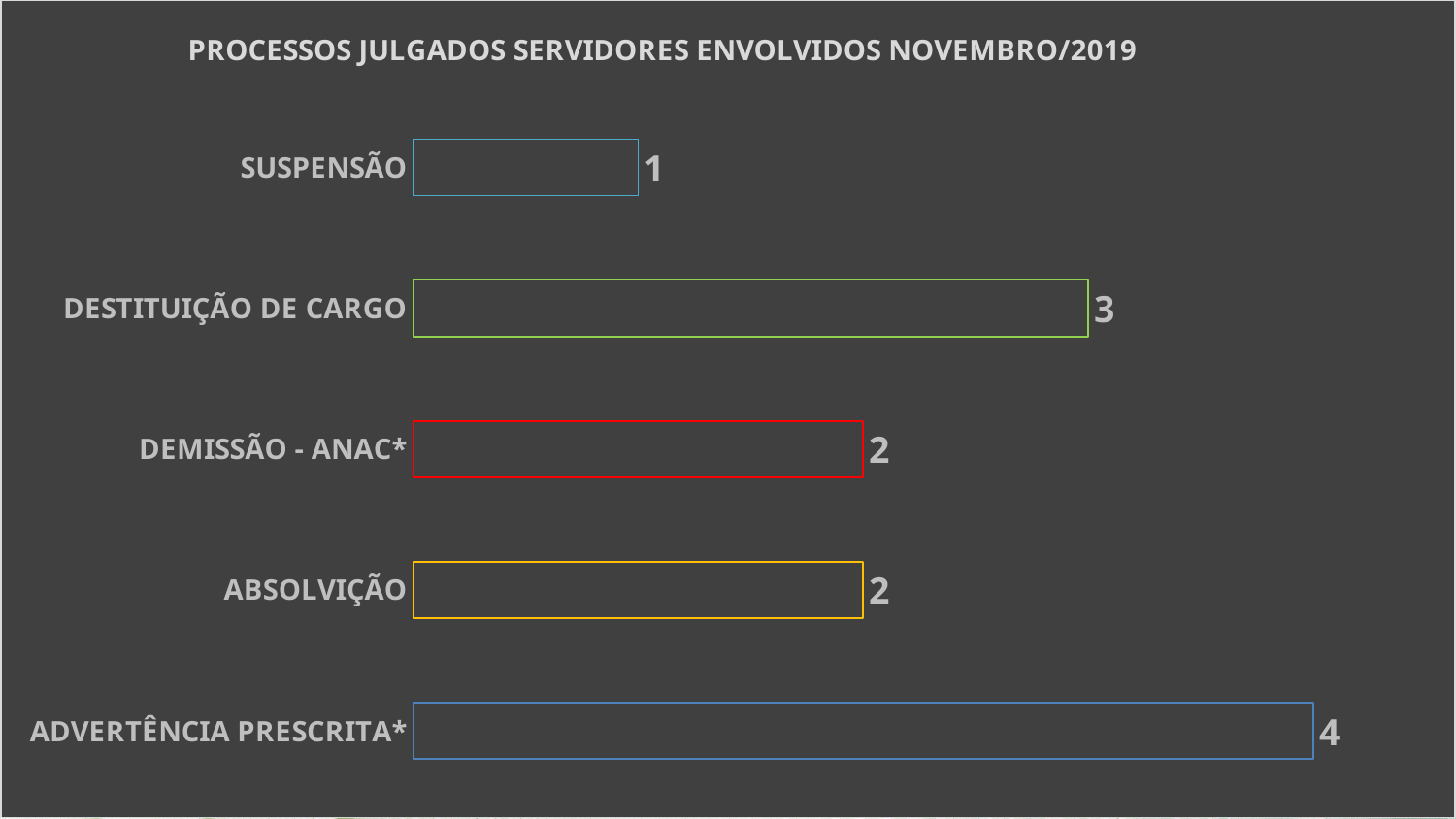
What is the difference between the values for ADVERTÊNCIA PRESCRITA* and SUSPENSÃO? 3 How many categories are shown in the chart? 5 What is the value for SUSPENSÃO? 1 What is the value for DESTITUIÇÃO DE CARGO? 3 Which category has the lowest value? SUSPENSÃO What colour is the outline of the bar for DEMISSÃO - ANAC*? Red What is the title of the chart? PROCESSOS JULGADOS SERVIDORES ENVOLVIDOS NOVEMBRO/2019 What is the value for DEMISSÃO - ANAC*? 2 What kind of chart is shown on the slide? Bar chart What is the value for ADVERTÊNCIA PRESCRITA*? 4 Which category has the highest value? ADVERTÊNCIA PRESCRITA* Which is larger, the value for DESTITUIÇÃO DE CARGO or the value for ABSOLVIÇÃO? DESTITUIÇÃO DE CARGO